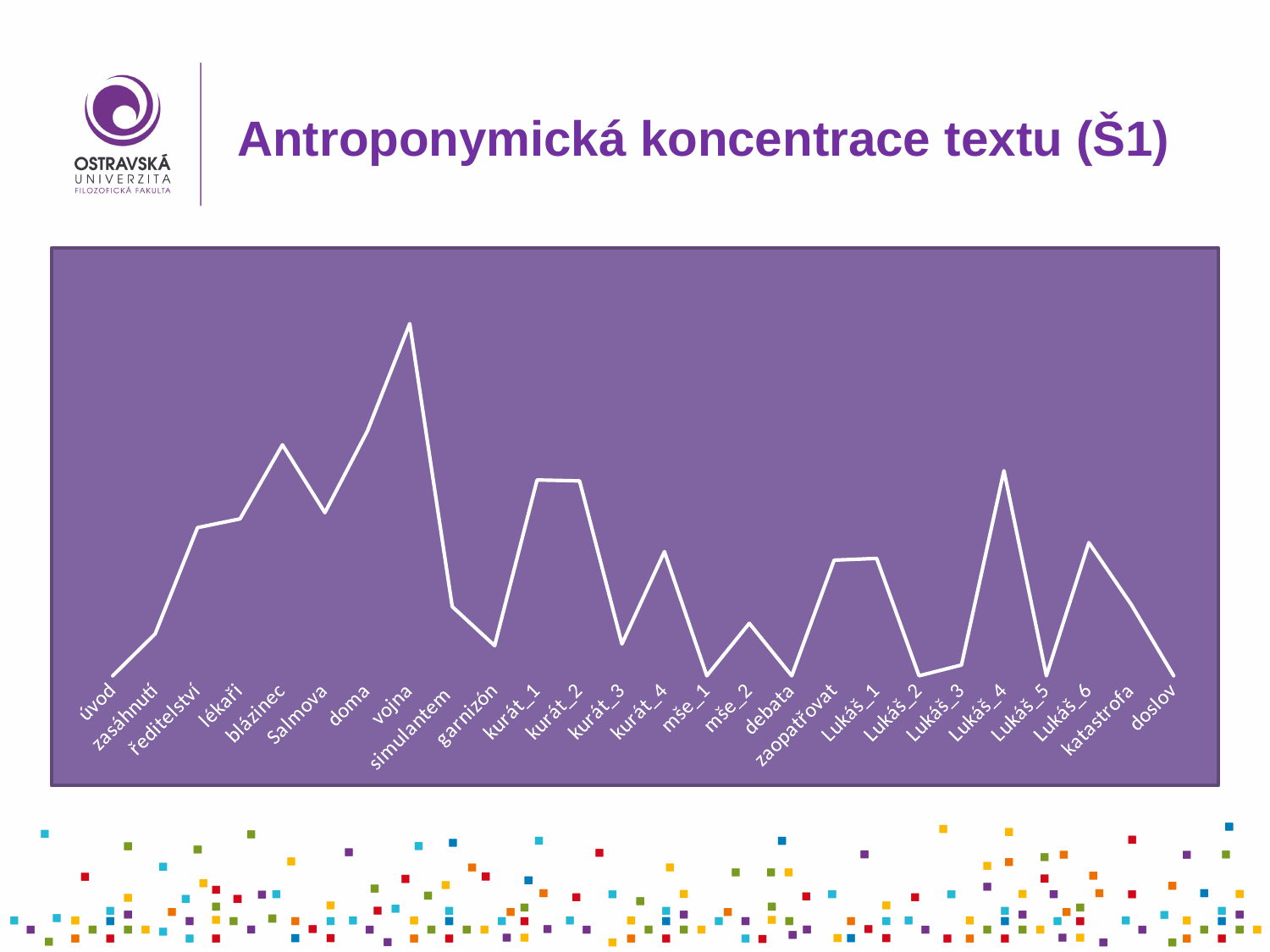
Do the values rise or fall from úvod to vojna? rise How many categories are plotted along the x axis of the chart? 26 Do the values rise or fall from Lukáš_6 to doslov? fall What is the title of the slide containing the chart? Antroponymická koncentrace textu (Š1) Which has the higher value, Lukáš_2 or Lukáš_4? Lukáš_4 What kind of chart is shown on the slide? line chart Which has the higher value, blázinec or Salmova? blázinec Which has the higher value, kurát_3 or kurát_4? kurát_4 What colour is the plotted line in the chart? white Which category has the highest value in the chart? vojna